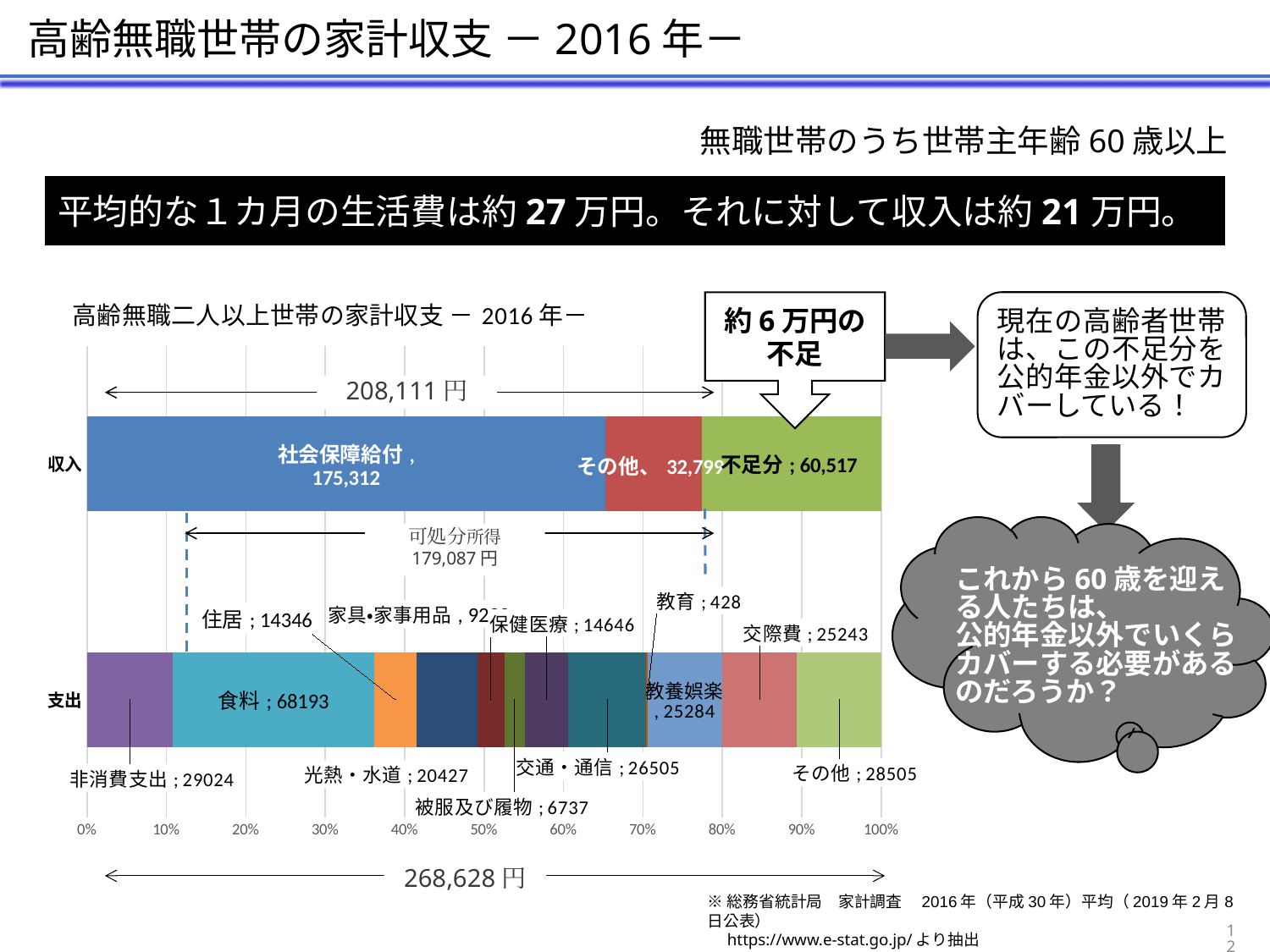
Which labelled category in the 支出 bar has the largest value? 食料 What is the difference between 不足分 (60,517) and その他 (32,799) in the 収入 bar? 27,718 What kind of chart is shown on the slide? Stacked bar chart What is the value of 社会保障給付 in the 収入 bar? 175,312 Which is larger in the 支出 bar, 交通・通信 or 光熱・水道? 交通・通信 What is the value of 教育 in the 支出 bar? 428 How many segments make up the 収入 bar? 3 What is the value of 食料 in the 支出 bar? 68193 What is the title of the chart? 高齢無職二人以上世帯の家計収支 － 2016 年－ What total amount is shown by the arrow below the 支出 bar? 268,628 円 What is the value of 不足分 in the 収入 bar? 60,517 Which labelled category in the 支出 bar has the smallest value? 教育